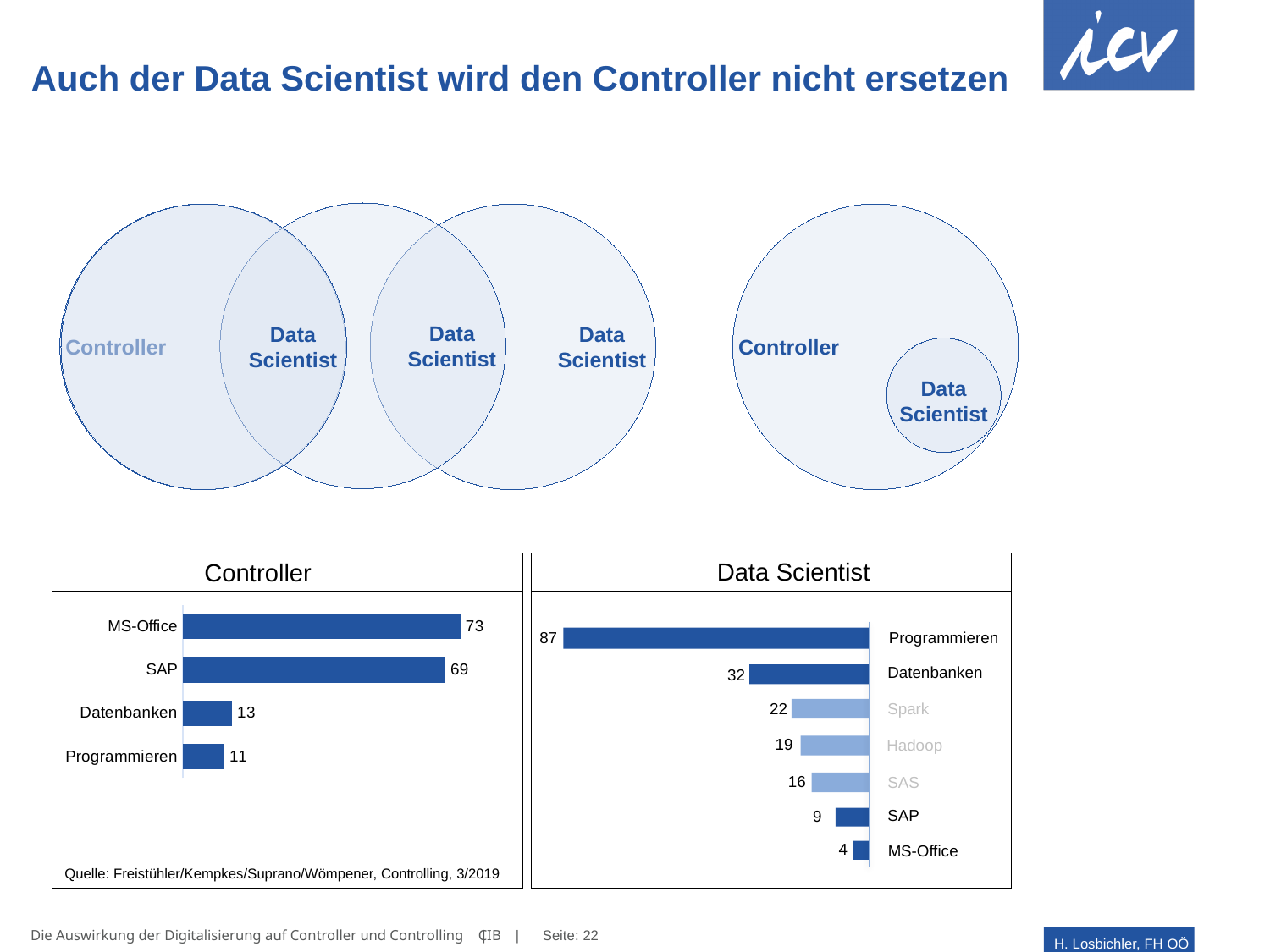
How many categories does the Controller chart show? 4 In the Controller chart, which category has the highest value? MS-Office In the Data Scientist chart, which category has the lowest value? MS-Office In the Data Scientist chart, what is the difference between the values for Programmieren and Datenbanken? 55 In the Data Scientist chart, which is larger, the value for Spark or the value for SAS? Spark In the Data Scientist chart, what is the value for Hadoop? 19 In the Controller chart, what is the value for Programmieren? 11 In the Controller chart, what is the difference between the values for SAP and Datenbanken? 56 How many categories does the Data Scientist chart show? 7 In the Controller chart, what is the value for MS-Office? 73 What kind of chart is the Data Scientist chart? Bar chart In the Data Scientist chart, what is the value for Programmieren? 87